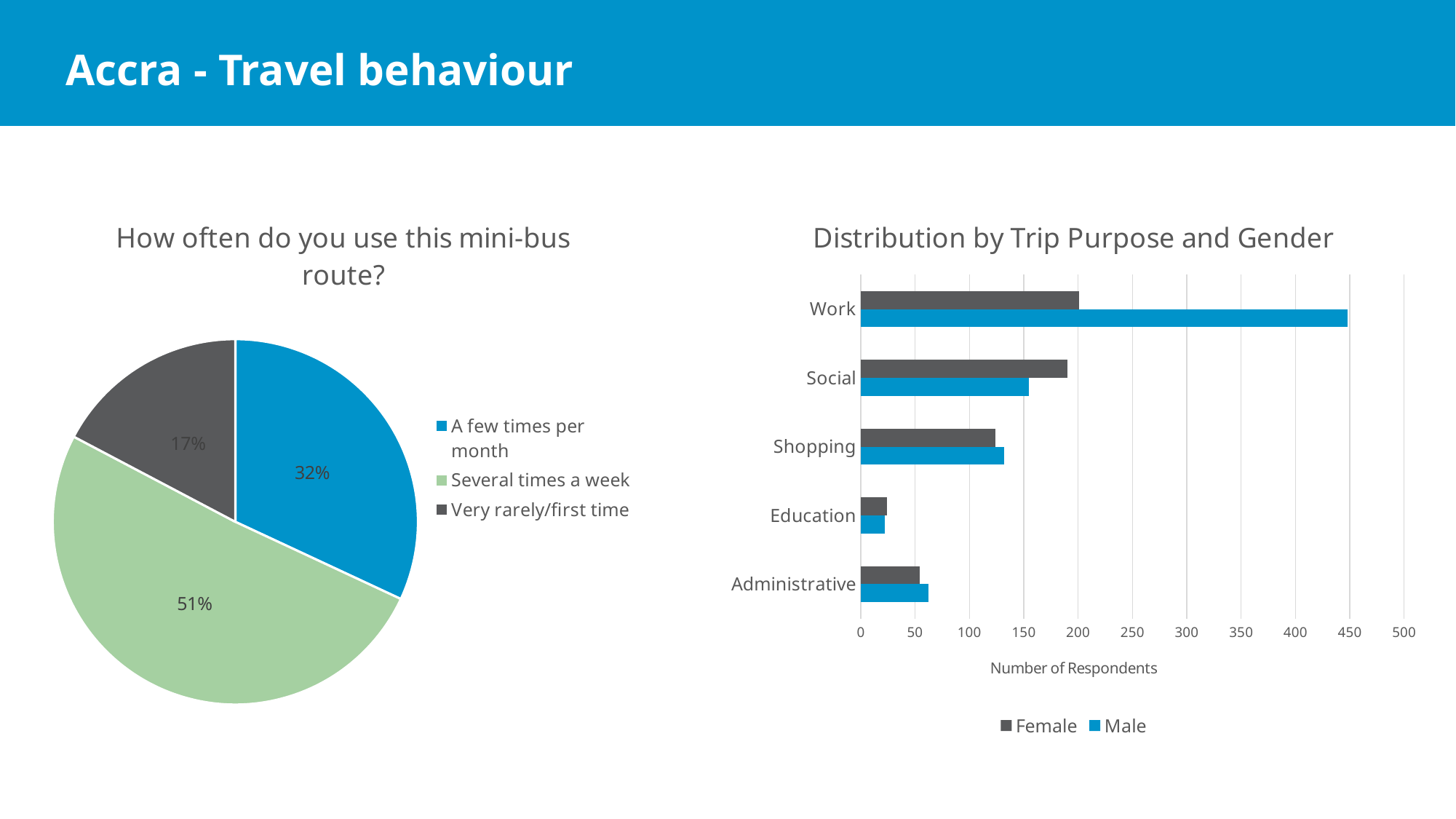
In the pie chart 'How often do you use this mini-bus route?', how many categories are shown? 3 In the pie chart 'How often do you use this mini-bus route?', what share of respondents use the route a few times per month? 32% In the chart 'Distribution by Trip Purpose and Gender', is the number of male respondents for Work greater or less than 400? greater In the pie chart 'How often do you use this mini-bus route?', which category has the largest share? Several times a week In the chart 'Distribution by Trip Purpose and Gender', which has more respondents for Social trips, Female or Male? Female In the pie chart 'How often do you use this mini-bus route?', what share of respondents use the route several times a week? 51% In the pie chart 'How often do you use this mini-bus route?', which category has the smallest share? Very rarely/first time In the pie chart 'How often do you use this mini-bus route?', what share of respondents use the route very rarely or for the first time? 17% What kind of chart is 'Distribution by Trip Purpose and Gender'? Bar chart In the chart 'Distribution by Trip Purpose and Gender', which trip purpose has the most male respondents? Work In the chart 'Distribution by Trip Purpose and Gender', how many series does the legend list? 2 In the pie chart 'How often do you use this mini-bus route?', how many percentage points larger is the 'Several times a week' share than the 'A few times per month' share? 19 percentage points